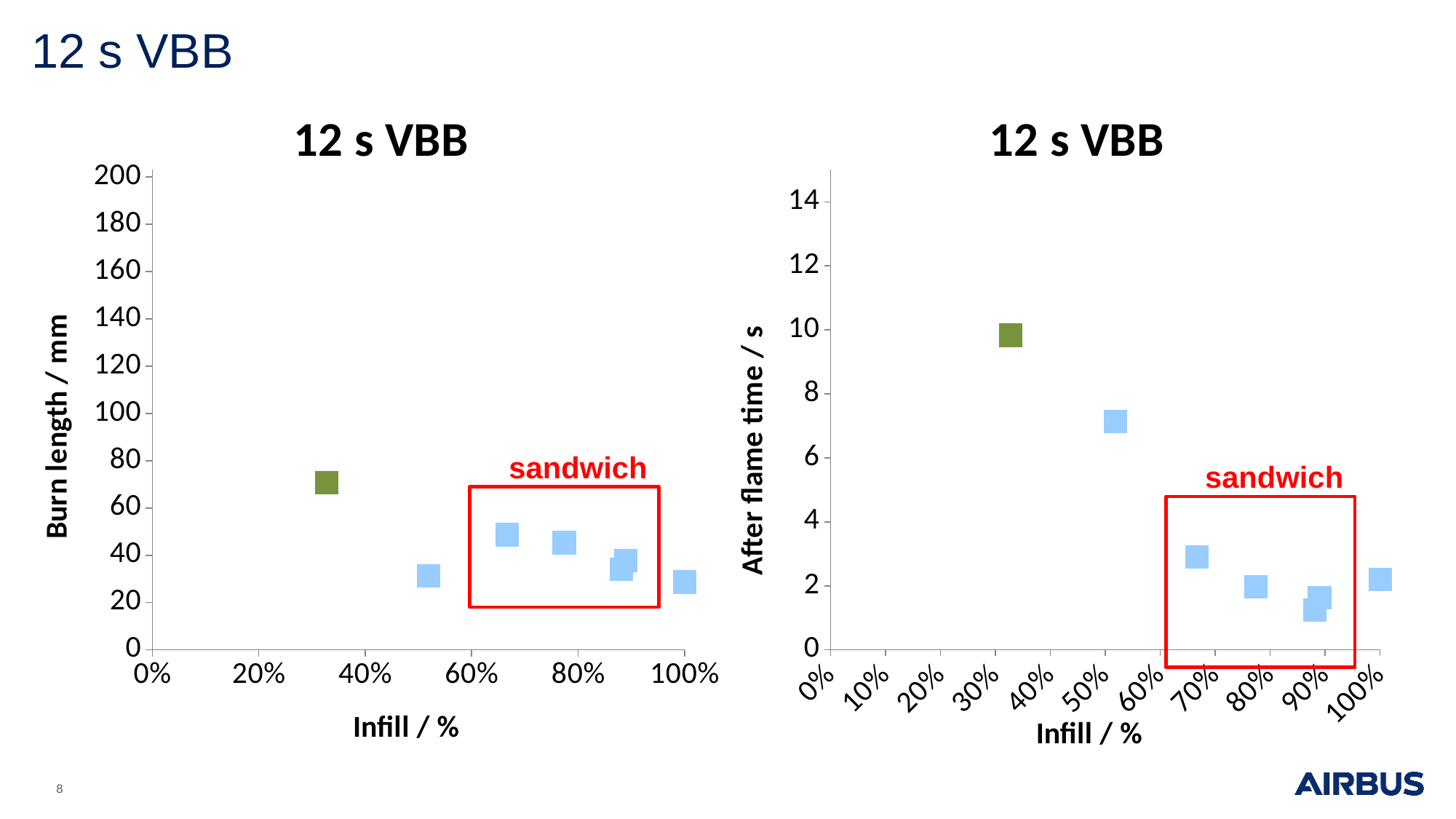
On the right chart (After flame time / s), is the value of the green point at about 33% infill greater or less than 8? greater On the right chart (After flame time / s), is the value of the point at about 52% infill greater or less than 6? greater What is the x-axis title of the right chart (After flame time / s)? Infill / % What label is written in red above the red box on both charts? sandwich On the left chart (Burn length / mm), which point has the highest burn length: the green point at about 33% infill or the blue point at about 100% infill? the green point at about 33% infill On the right chart (After flame time / s), does the after flame time generally rise or fall as infill increases? fall What is the maximum value shown on the y axis of the right chart (After flame time / s)? 14 On the left chart (Burn length / mm), does the burn length generally rise or fall as infill increases? fall What kind of chart is the left chart titled '12 s VBB' with the y axis 'Burn length / mm'? scatter chart On the left chart (Burn length / mm), is the value of the green point at about 33% infill greater or less than 60? greater